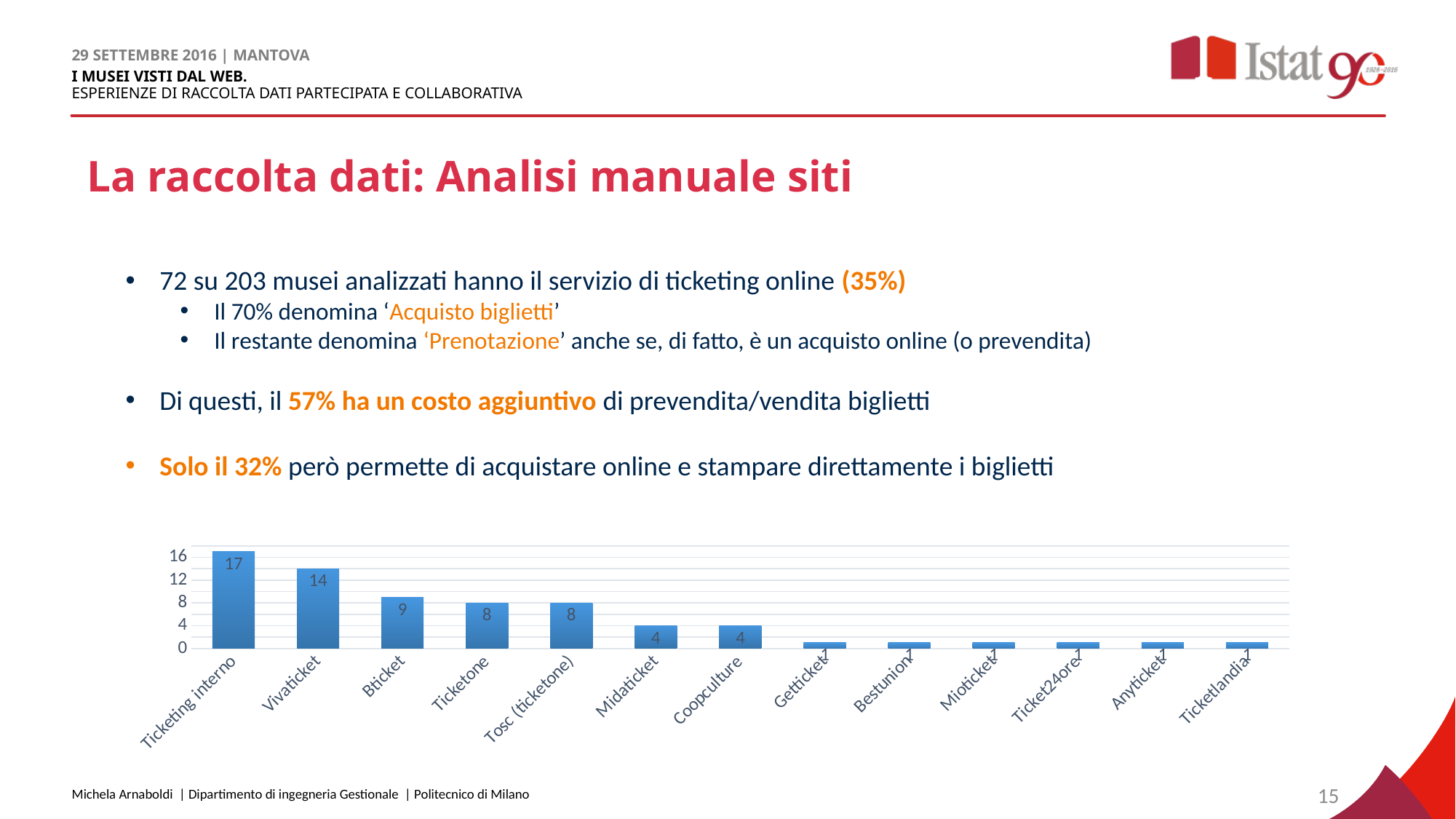
What kind of chart is shown on the slide? bar chart Which category has the highest value? Ticketing interno Do the values rise or fall from left to right along the x axis? fall What is the value for Vivaticket? 14 What is the difference between the values for Ticketing interno and Vivaticket? 3 What is the difference between the values for Bticket and Coopculture? 5 What is the value for Bticket? 9 How many categories are shown on the x axis? 13 What is the value for Ticketing interno? 17 Is the value for Ticketing interno greater or less than 12? greater What is the value for Midaticket? 4 Which is larger, the value for Vivaticket or the value for Ticketone? Vivaticket